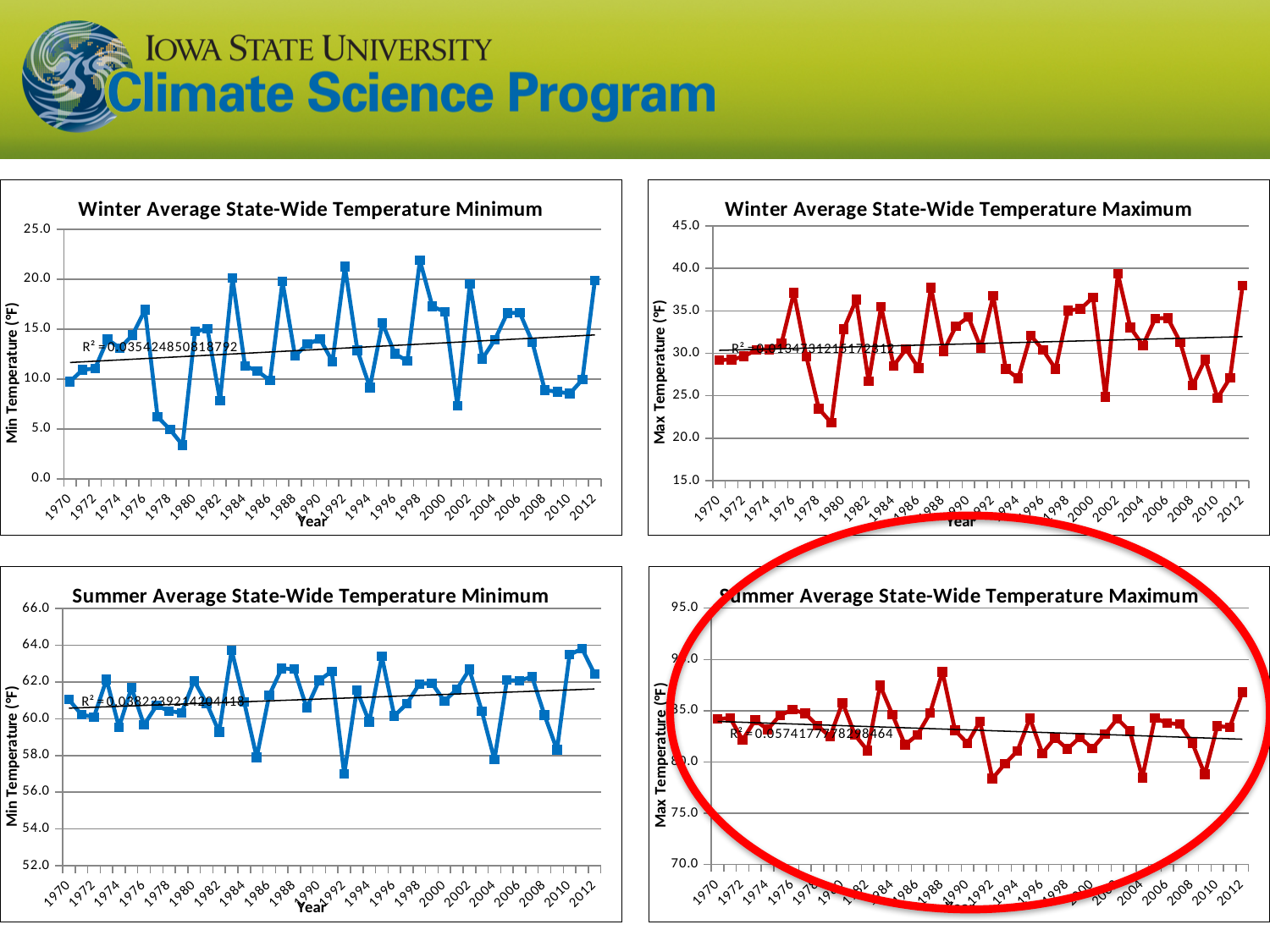
In the "Winter Average State-Wide Temperature Minimum" chart, which year has the lowest value? 1979 In the "Winter Average State-Wide Temperature Minimum" chart, is the value for 1998 greater or less than 20.0? greater What kind of chart is the "Winter Average State-Wide Temperature Minimum" chart? line chart In the "Summer Average State-Wide Temperature Maximum" chart, which year has the highest value? 1988 In the "Winter Average State-Wide Temperature Minimum" chart, is the value for 1979 greater or less than 5.0? less In the "Summer Average State-Wide Temperature Minimum" chart, which year has the lowest value? 1992 In the "Winter Average State-Wide Temperature Maximum" chart, is the value for 1979 greater or less than 25.0? less In the "Winter Average State-Wide Temperature Maximum" chart, which year has the highest value? 2002 Which chart on the slide is highlighted with a red circle? Summer Average State-Wide Temperature Maximum In the "Summer Average State-Wide Temperature Maximum" chart, does the fitted trend line rise or fall from 1970 to 2012? fall How many charts are shown on the slide? 4